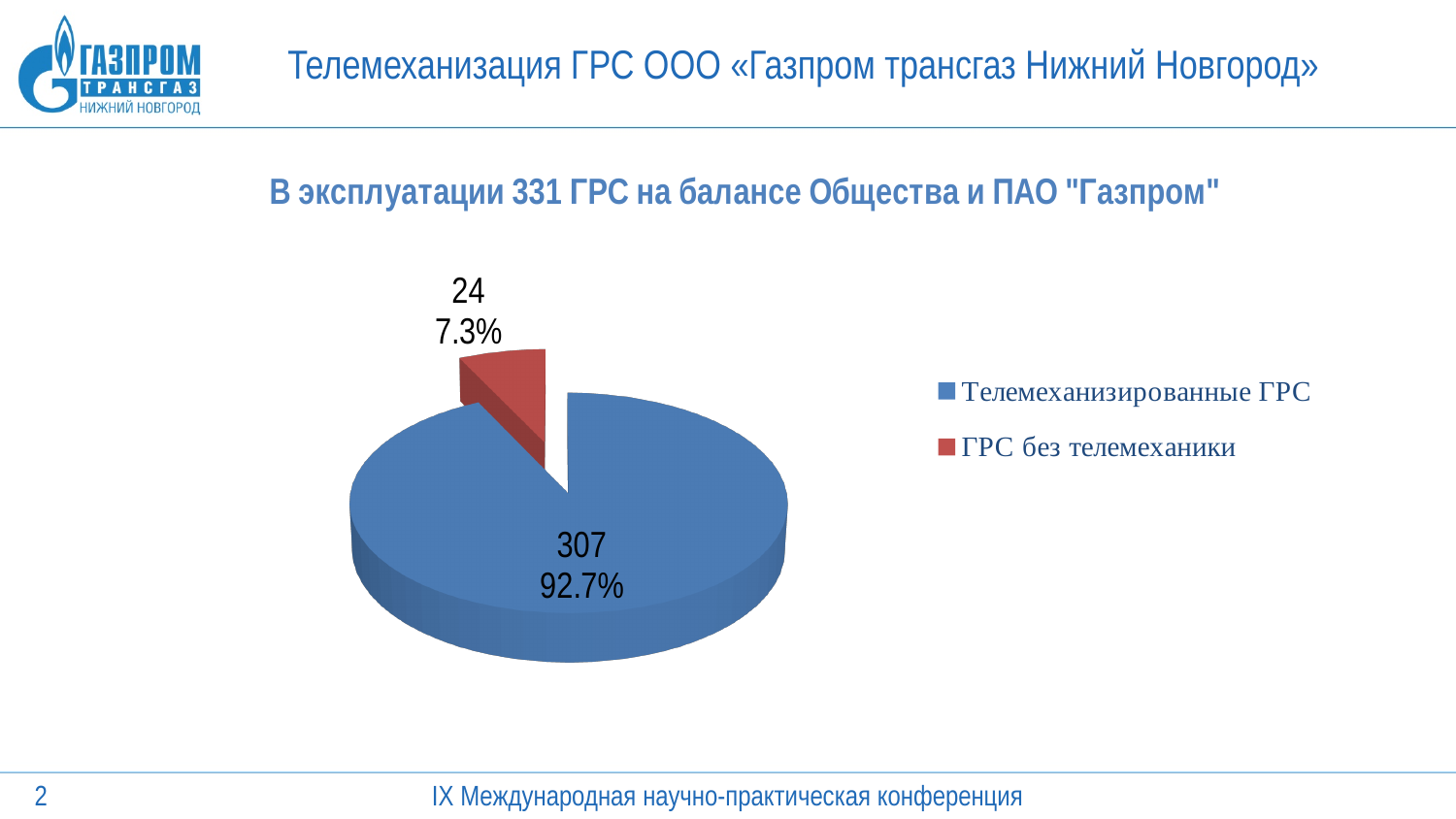
What colour is the slice for ГРС без телемеханики? red How many slices does the pie chart have? 2 What kind of chart is shown on the slide? pie chart What is the value for Телемеханизированные ГРС? 307 What share of the pie does ГРС без телемеханики represent? 7.3% What is the difference between the values for Телемеханизированные ГРС and ГРС без телемеханики? 283 How many series does the legend list? 2 What is the value for ГРС без телемеханики? 24 What is the total of the two slices in the pie chart? 331 Which category has the largest slice? Телемеханизированные ГРС What share of the pie does Телемеханизированные ГРС represent? 92.7% Which category has the smallest slice? ГРС без телемеханики